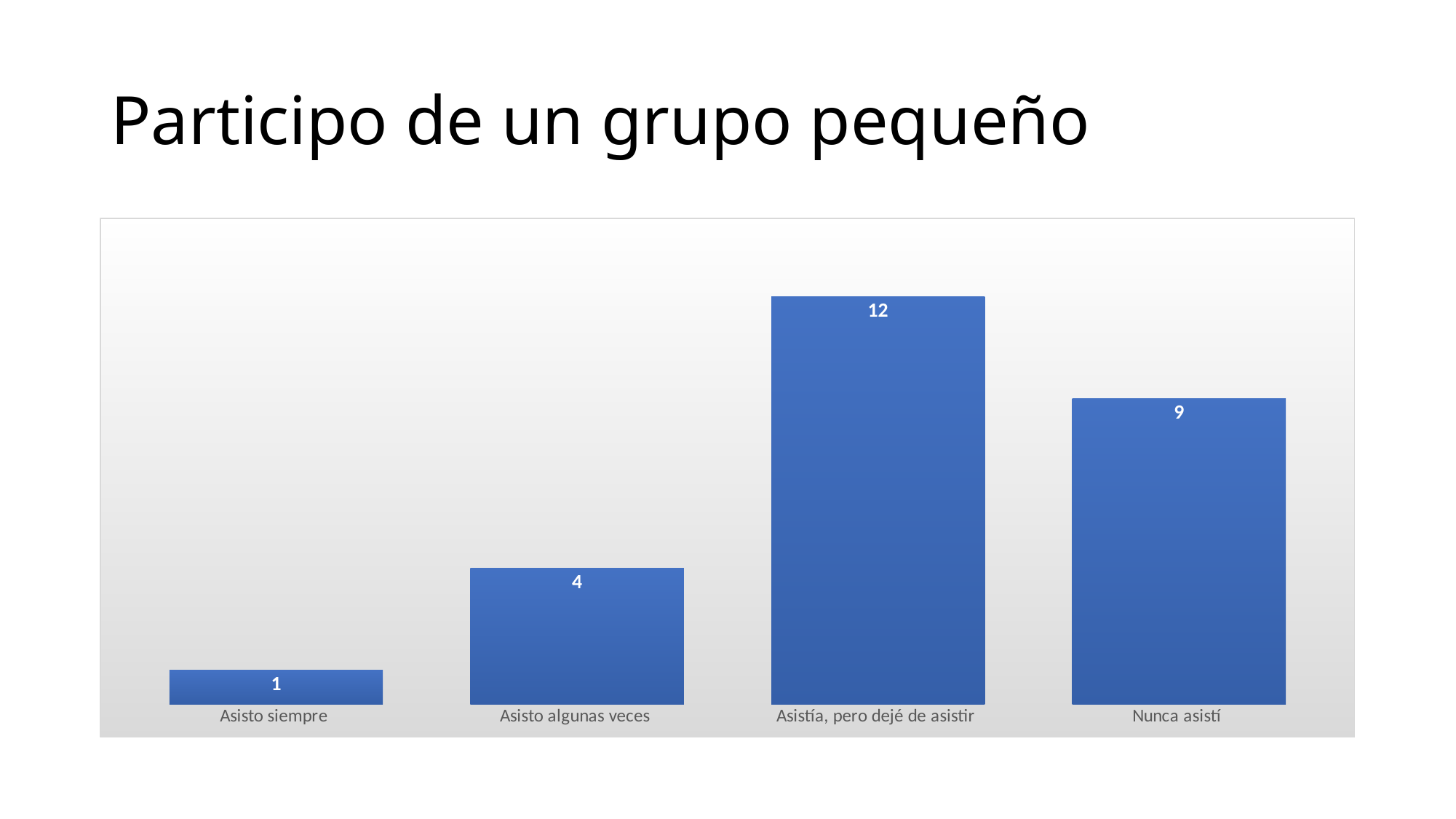
What is the value for "Asistía, pero dejé de asistir"? 12 What is the value for "Asisto algunas veces"? 4 Which is larger, the value for "Nunca asistí" or the value for "Asisto algunas veces"? Nunca asistí What is the title of the slide? Participo de un grupo pequeño What is the difference between the values for "Asistía, pero dejé de asistir" and "Nunca asistí"? 3 What is the value for "Asisto siempre"? 1 What kind of chart is shown on the slide? Bar chart Which category has the lowest value? Asisto siempre How many categories are shown in the chart? 4 What is the value for "Nunca asistí"? 9 Which category has the highest value? Asistía, pero dejé de asistir What is the difference between the values for "Asisto algunas veces" and "Asisto siempre"? 3